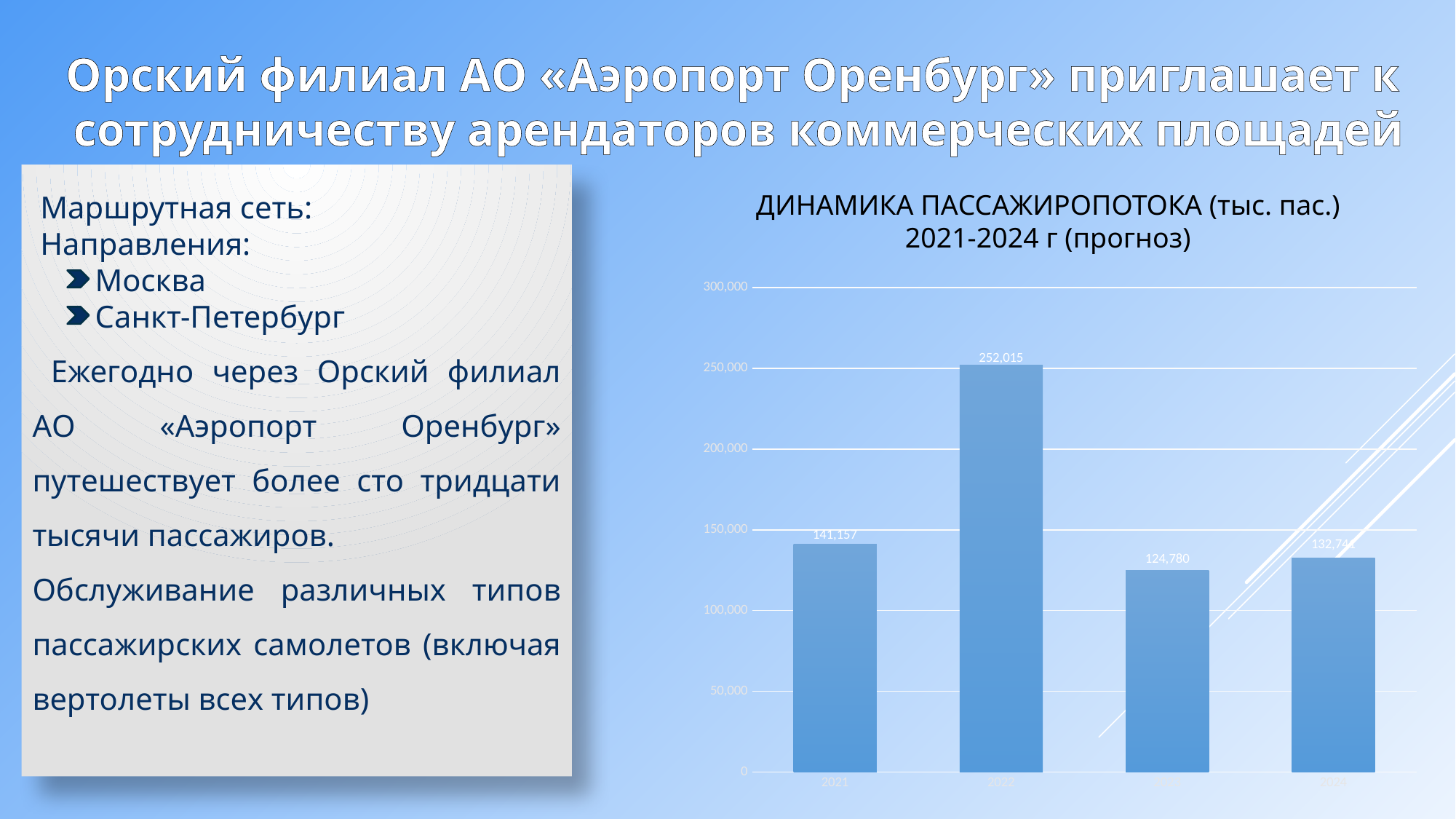
What is the value for 2022 in the chart ДИНАМИКА ПАССАЖИРОПОТОКА? 252,015 In the chart ДИНАМИКА ПАССАЖИРОПОТОКА, is the value for 2024 greater or less than 150,000? less What is the value for 2021 in the chart ДИНАМИКА ПАССАЖИРОПОТОКА? 141,157 What type of chart is shown on the slide? Bar chart In the chart ДИНАМИКА ПАССАЖИРОПОТОКА, is the value for 2022 greater or less than 250,000? greater What is the value for 2023 (the third bar) in the chart ДИНАМИКА ПАССАЖИРОПОТОКА? 124,780 What is the difference between the values for 2021 and 2023 in the chart ДИНАМИКА ПАССАЖИРОПОТОКА? 16,377 How many bars are shown in the chart ДИНАМИКА ПАССАЖИРОПОТОКА? 4 Which year has the lowest value in the chart ДИНАМИКА ПАССАЖИРОПОТОКА? 2023 Which year has the highest value in the chart ДИНАМИКА ПАССАЖИРОПОТОКА? 2022 In the chart ДИНАМИКА ПАССАЖИРОПОТОКА, which is larger: the value for 2021 or the value for 2024? 2021 What is the difference between the values for 2022 and 2021 in the chart ДИНАМИКА ПАССАЖИРОПОТОКА? 110,858